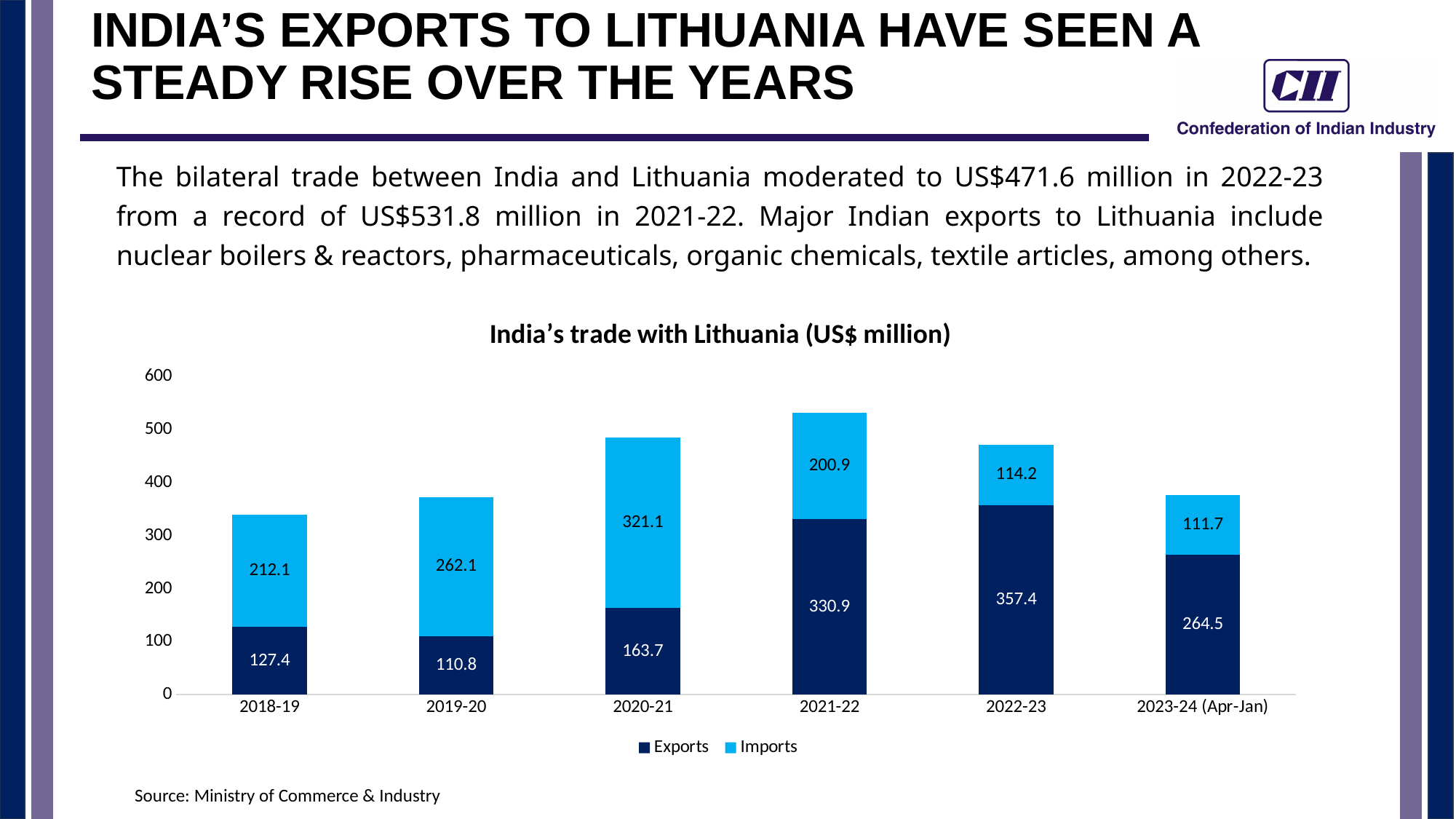
What is the difference between Exports in 2022-23 and Exports in 2021-22? 26.5 How many years are shown on the x axis? 6 What is the value of Imports for 2019-20? 262.1 Which year has the lowest Imports value? 2023-24 (Apr-Jan) Which is larger in 2020-21, Exports or Imports? Imports What is the title of the chart? India's trade with Lithuania (US$ million) What kind of chart is shown on the slide? Stacked bar chart Which year has the highest Exports value? 2022-23 Is the total stacked bar for 2021-22 greater or less than 500? greater What is the total of the stacked bar for 2022-23? 471.6 What is the value of Exports for 2021-22? 330.9 How many series does the legend list? 2